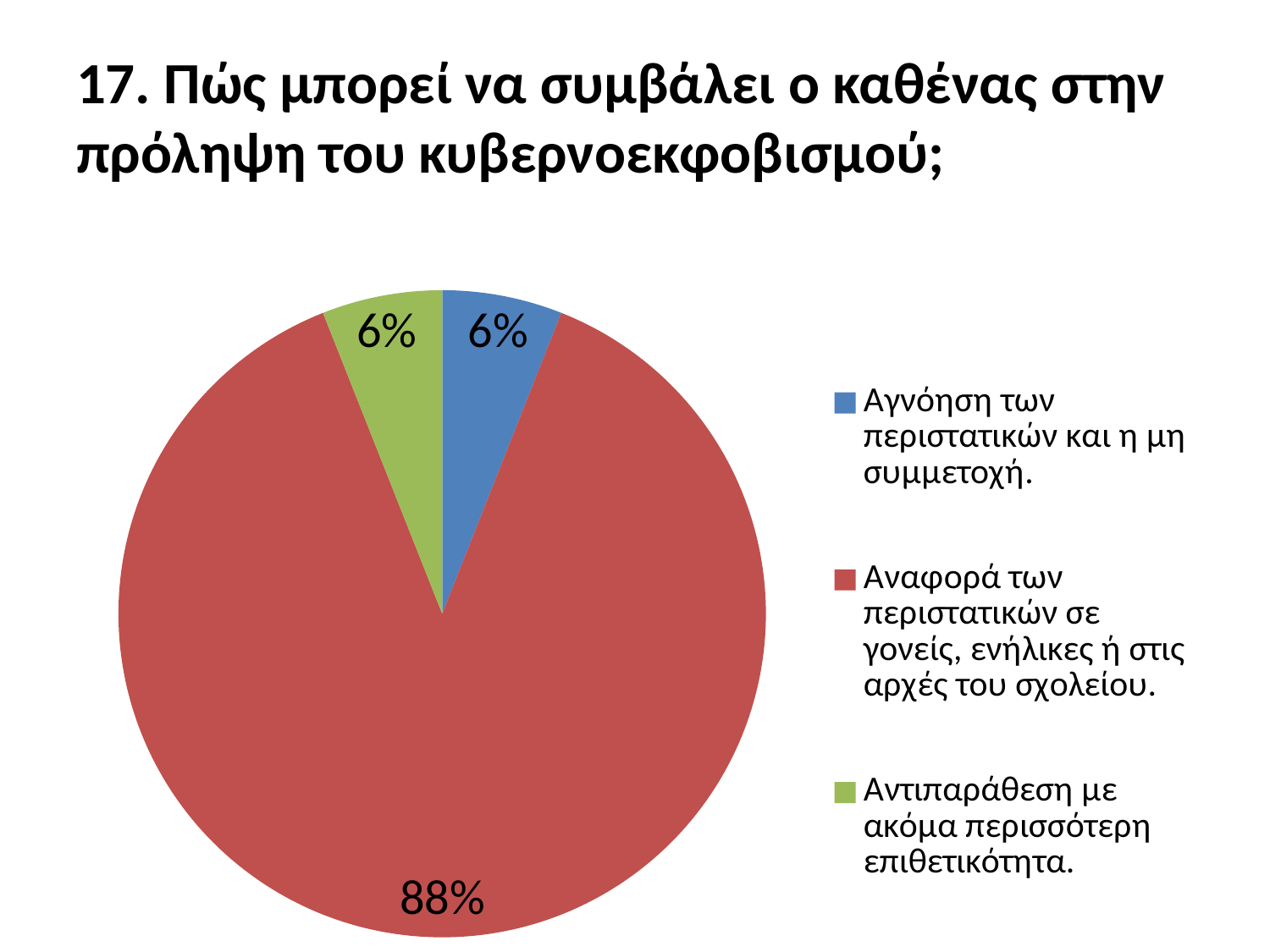
What percentage is shown for "Αναφορά των περιστατικών σε γονείς, ενήλικες ή στις αρχές του σχολείου."? 88% What colour is the slice for "Αντιπαράθεση με ακόμα περισσότερη επιθετικότητα."? green Which category has the largest share of the pie? Αναφορά των περιστατικών σε γονείς, ενήλικες ή στις αρχές του σχολείου. How many entries does the legend list? 3 What is the difference in percentage points between the "Αναφορά των περιστατικών" slice and the "Αγνόηση των περιστατικών" slice? 82 What percentage is shown for "Αγνόηση των περιστατικών και η μη συμμετοχή."? 6% Which is larger: the share for "Αναφορά των περιστατικών σε γονείς, ενήλικες ή στις αρχές του σχολείου." or the share for "Αντιπαράθεση με ακόμα περισσότερη επιθετικότητα."? Αναφορά των περιστατικών σε γονείς, ενήλικες ή στις αρχές του σχολείου. What colour is the slice for "Αναφορά των περιστατικών σε γονείς, ενήλικες ή στις αρχές του σχολείου."? red How many slices does the pie chart have? 3 What percentage is shown for "Αντιπαράθεση με ακόμα περισσότερη επιθετικότητα."? 6% What kind of chart is shown on the slide? pie chart What is the combined share of the two 6% slices? 12%